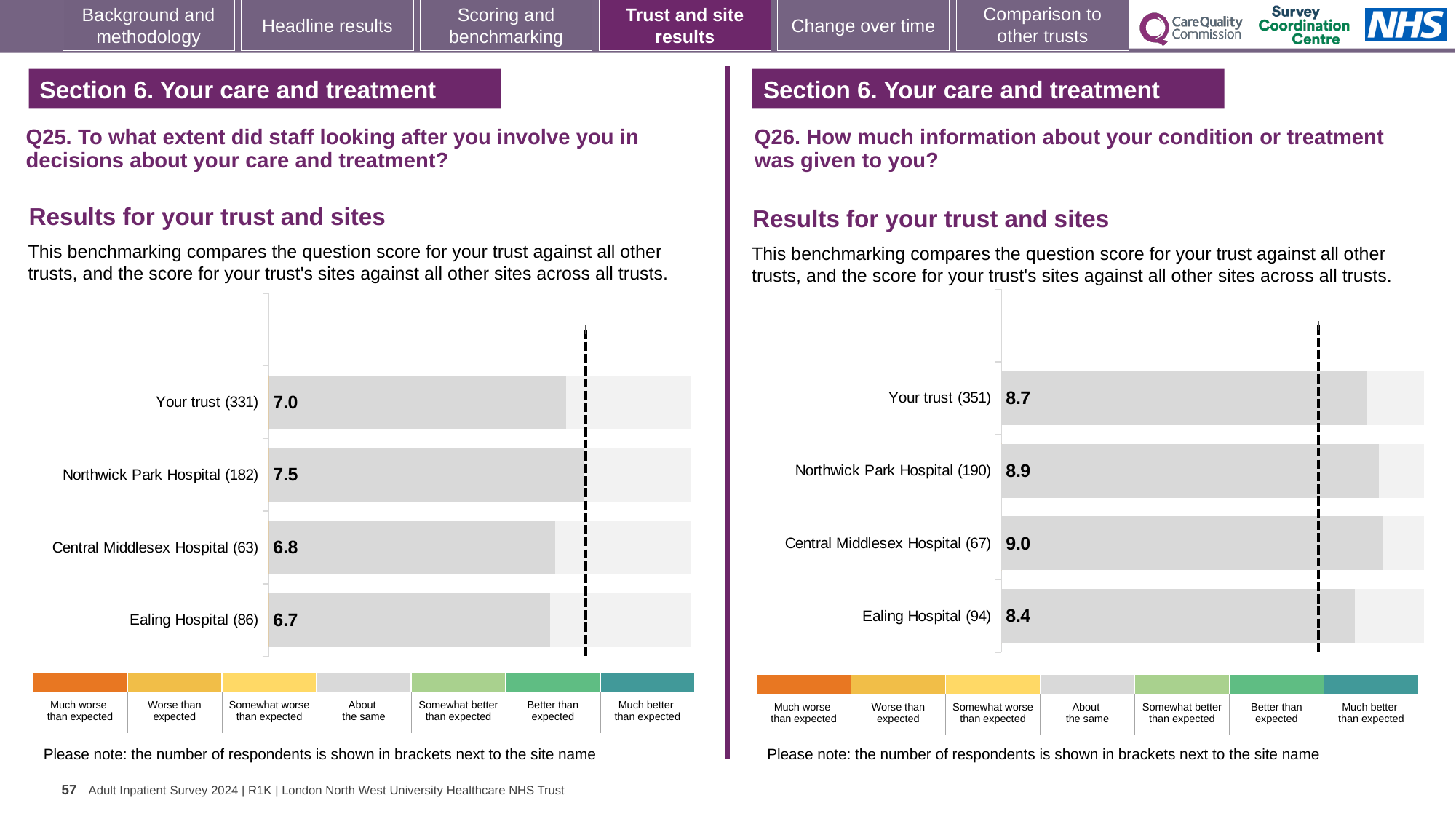
In the Q26 chart on the right, what is the score for Central Middlesex Hospital (67)? 9.0 In the Q26 chart on the right, what is the score for Ealing Hospital (94)? 8.4 In the Q25 chart on the left, what is the difference between the scores for Northwick Park Hospital and Central Middlesex Hospital? 0.7 What type of chart is used for the Q26 results on the right? Bar chart In the Q25 chart on the left, which site has the lowest score? Ealing Hospital (86) In the Q25 chart on the left, which bar has the highest score? Northwick Park Hospital (182) In the Q25 chart on the left, what is the score for Your trust (331)? 7.0 In the Q26 chart on the right, which site has the highest score? Central Middlesex Hospital (67) How many bars are plotted in the Q25 chart on the left? 4 In the Q26 chart on the right, what is the difference between the scores for Your trust and Ealing Hospital? 0.3 In the Q25 chart on the left, what is the score for Northwick Park Hospital (182)? 7.5 In the Q26 chart on the right, which is larger: the score for Your trust or the score for Northwick Park Hospital? Northwick Park Hospital